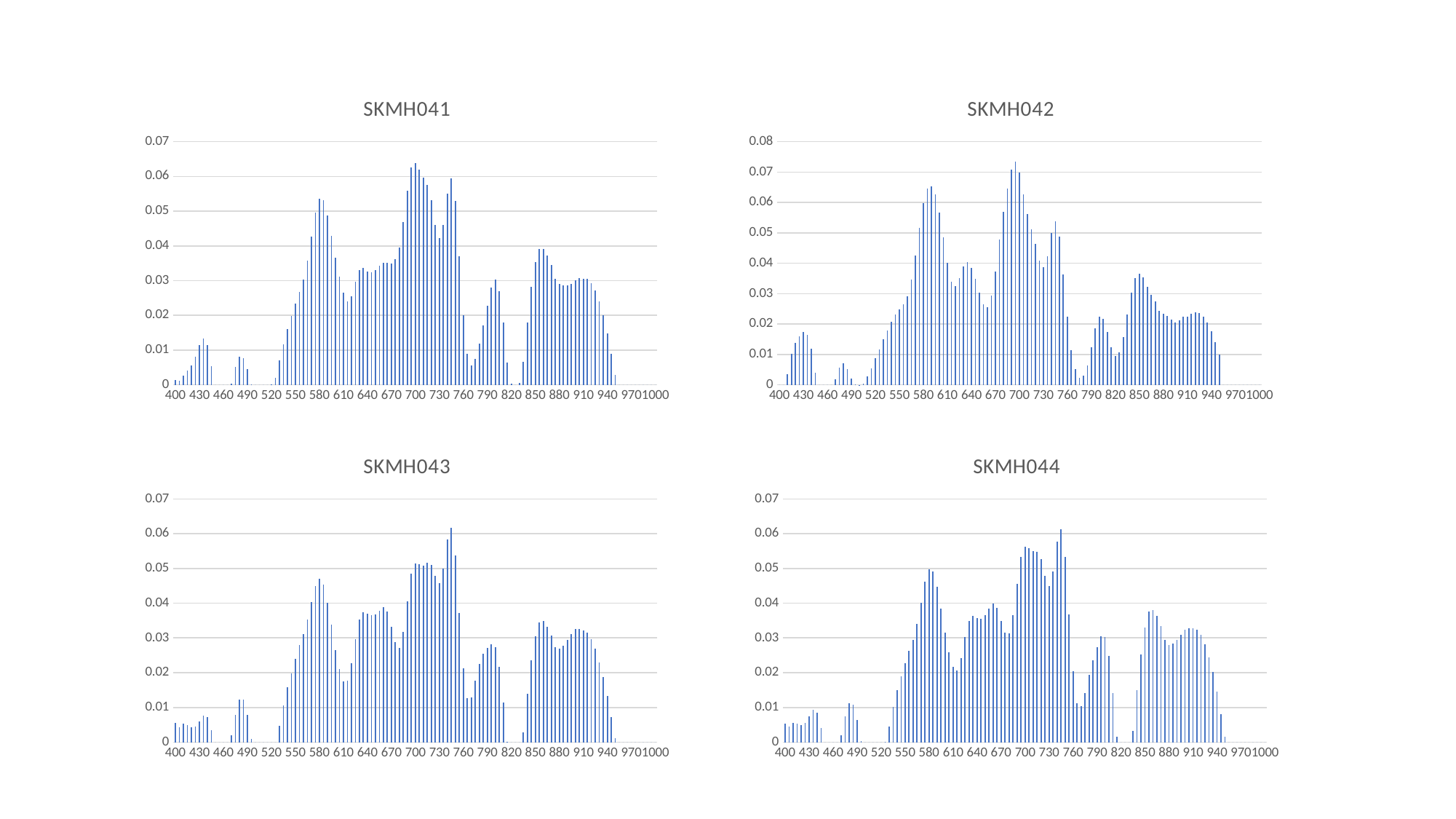
In the SKMH042 chart, is the value at 700 greater or less than 0.06? greater In the SKMH042 chart, is the value at 520 greater or less than 0.03? less What is the title of the top-left chart? SKMH041 What kind of chart is SKMH041? bar chart In the SKMH041 chart, is the value at 700 greater or less than 0.05? greater How many charts are shown on the slide? 4 What is the highest value shown on the y axis of the SKMH042 chart? 0.08